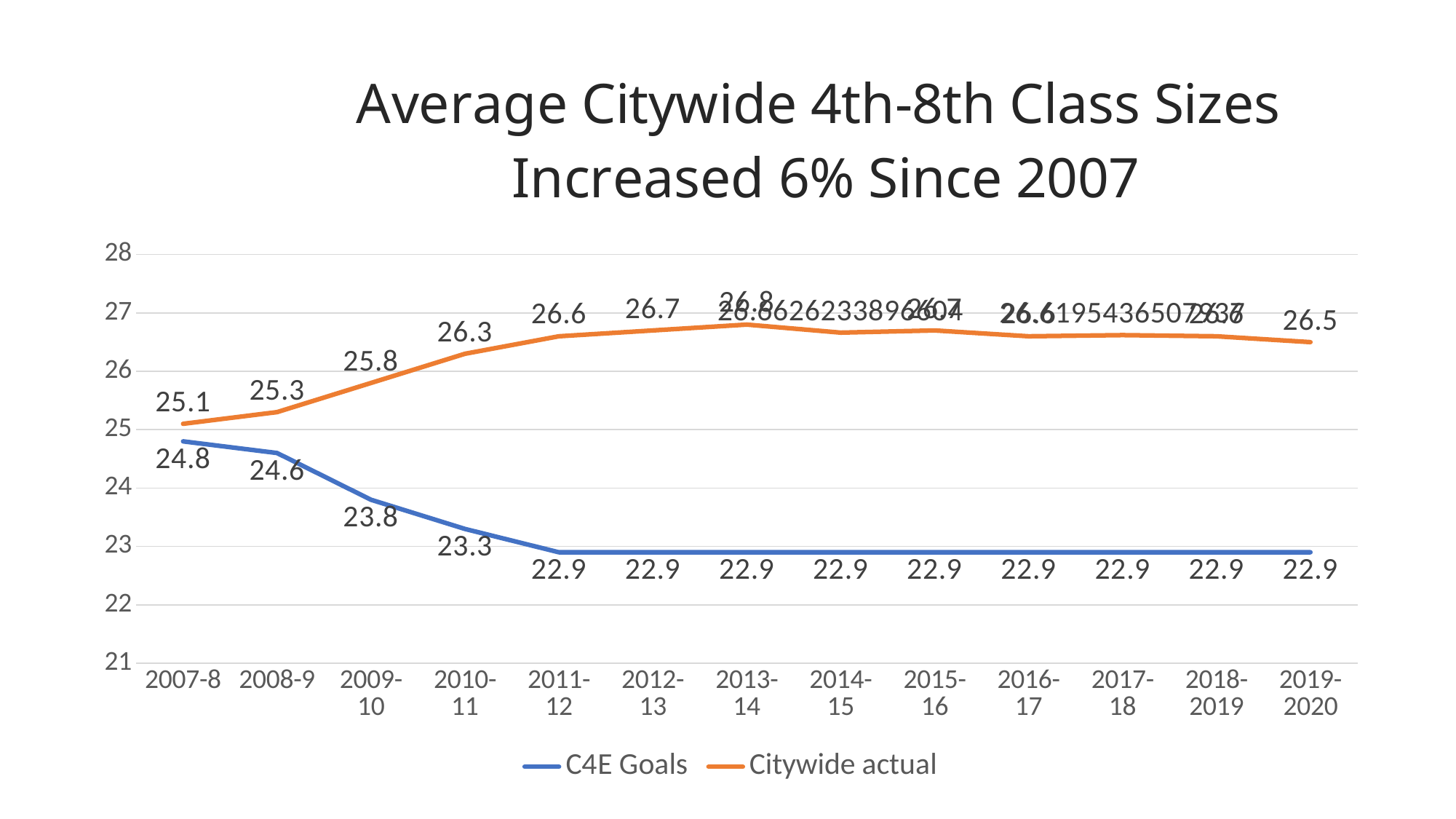
How many series does the legend list? 2 What is the Citywide actual value for 2007-8? 25.1 What is the Citywide actual value for 2019-2020? 26.5 What is the C4E Goals value for 2011-12? 22.9 What type of chart is shown on the slide? line chart Which is larger in 2010-11, the Citywide actual value or the C4E Goals value? Citywide actual How many school years are shown on the x axis? 13 Which school year has the highest C4E Goals value? 2007-8 Which school year has the highest Citywide actual value? 2013-14 What is the C4E Goals value for 2009-10? 23.8 What is the difference between the Citywide actual and C4E Goals values in 2007-8? 0.3 What is the difference between the Citywide actual and C4E Goals values in 2012-13? 3.8